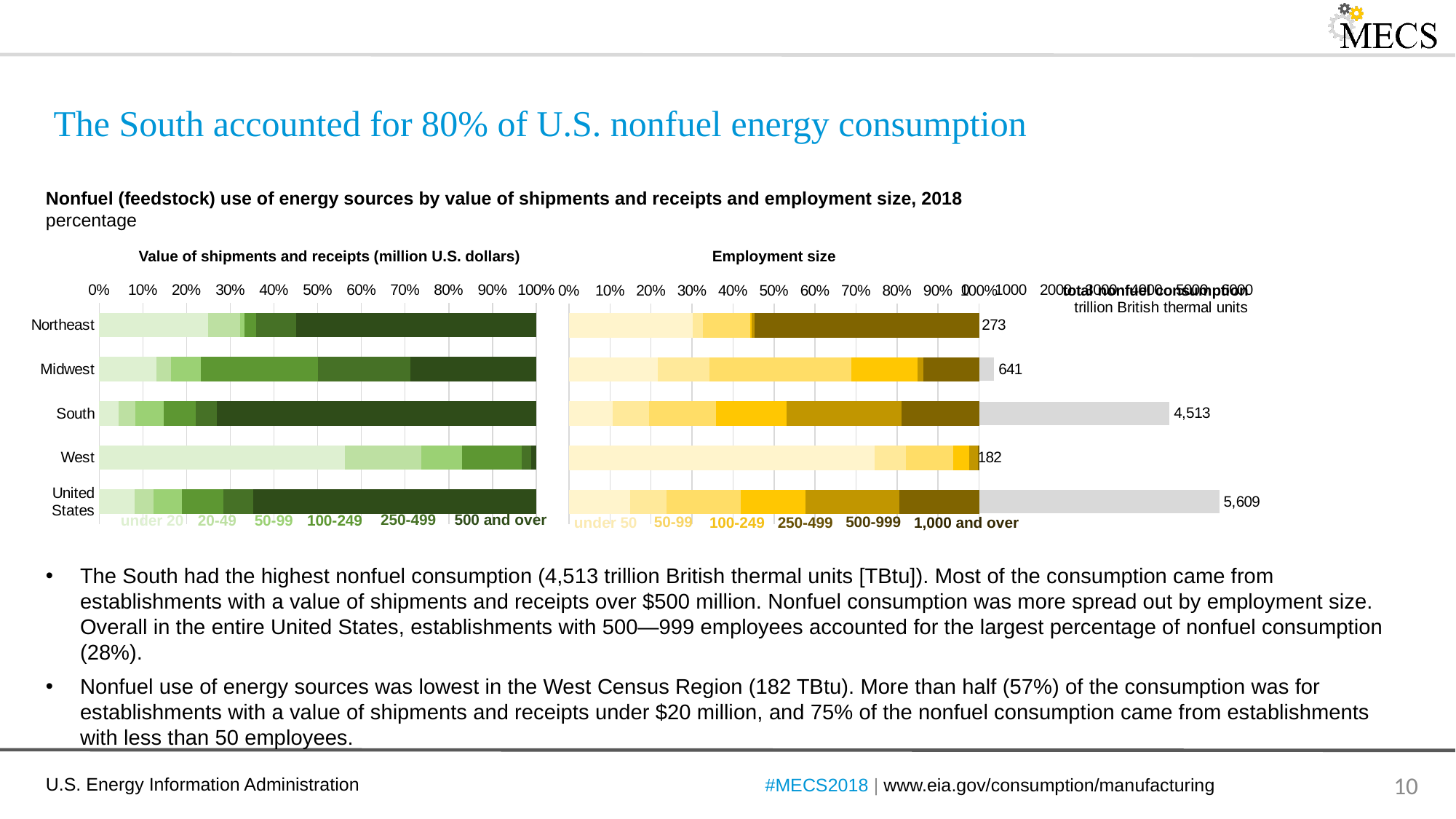
On the total nonfuel consumption chart, what is the value for the United States? 5,609 On the total nonfuel consumption chart, which is larger: the Northeast or the West? Northeast What unit is given for the total nonfuel consumption chart? trillion British thermal units On the total nonfuel consumption chart, what is the difference between the Midwest and Northeast values? 368 On the total nonfuel consumption chart, what is the value for the South? 4,513 On the total nonfuel consumption chart, what is the value for the Midwest? 641 On the Value of shipments and receipts chart, is the 'under 20' share for the West greater or less than 50%? greater On the total nonfuel consumption chart, which region has the lowest value? West What kind of chart is the Value of shipments and receipts chart? Stacked bar chart How many series does the legend of the Employment size chart list? 6 On the total nonfuel consumption chart, which region has the highest value (excluding the United States total)? South How many categories (rows) are shown on the Value of shipments and receipts chart? 5